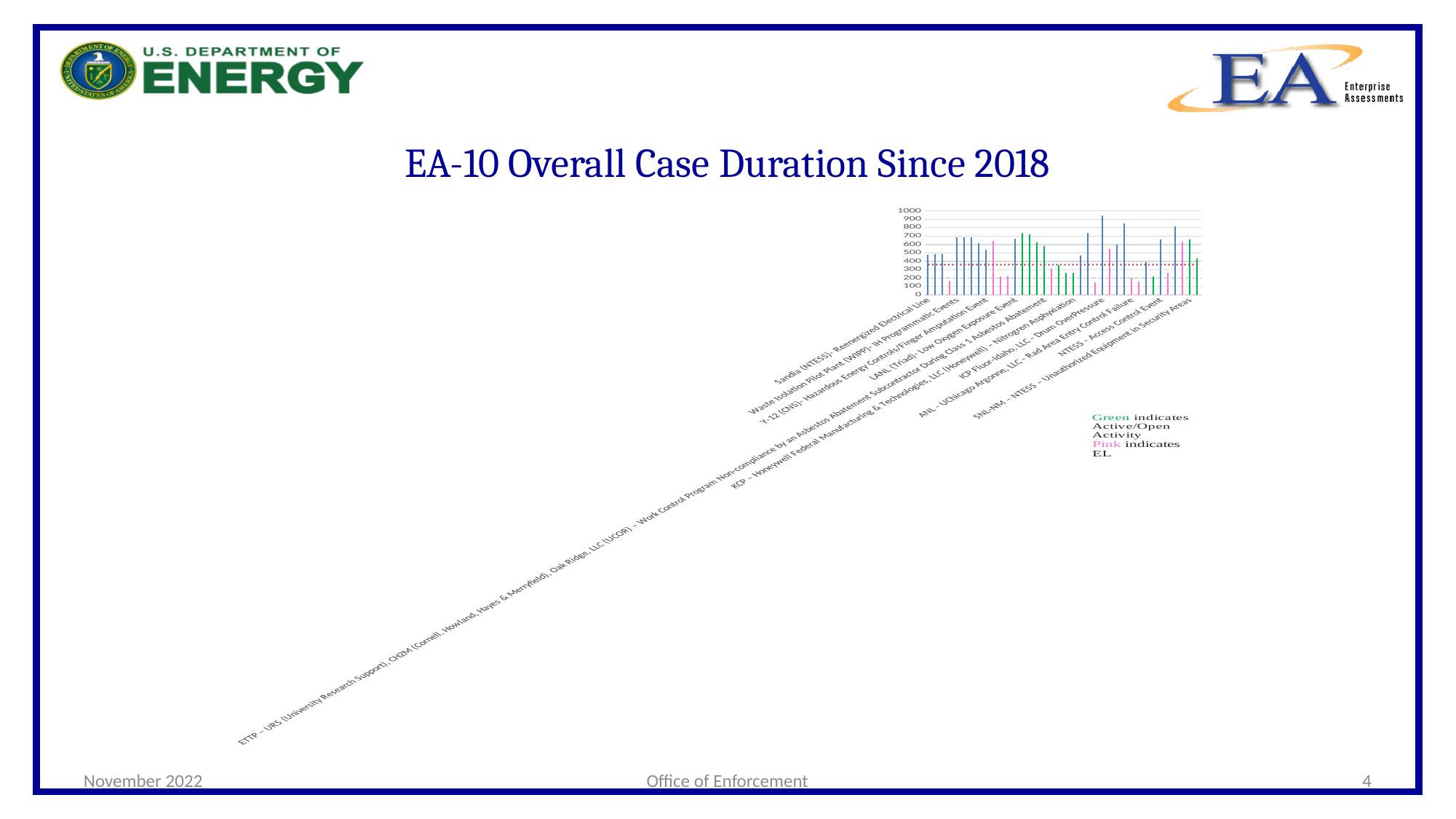
Is the value of the tallest bar in the chart greater or less than 800? greater According to the chart's note, what does a green bar indicate? Active/Open Activity What kind of chart is shown on the slide? bar chart What is the highest value shown on the chart's vertical axis? 1000 What is the title of the slide's chart? EA-10 Overall Case Duration Since 2018